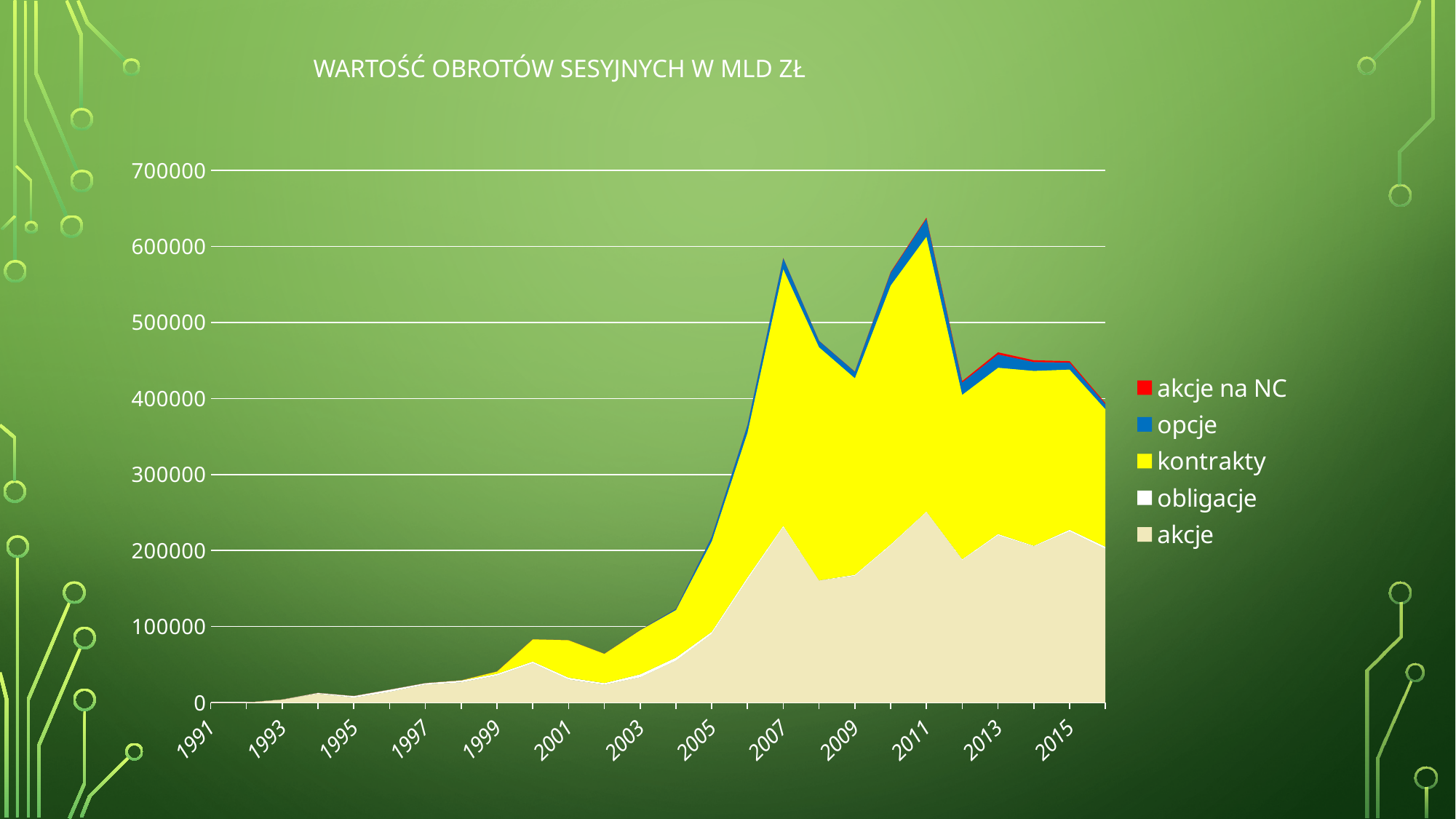
Does the total value rise or fall from 2011 to 2012? fall What kind of chart is shown on the slide? Stacked area chart Is the total value for 2007 greater or less than 500000? greater Which series is shown in yellow? kontrakty What is the title of the chart? WARTOŚĆ OBROTÓW SESYJNYCH W MLD ZŁ In which year does the total stacked value reach its highest point? 2011 Is the total value for 2013 greater or less than 400000? greater Is the value for akcje in 2009 greater or less than 200000? less Which year has the larger total value, 2007 or 2009? 2007 How many series does the legend list? 5